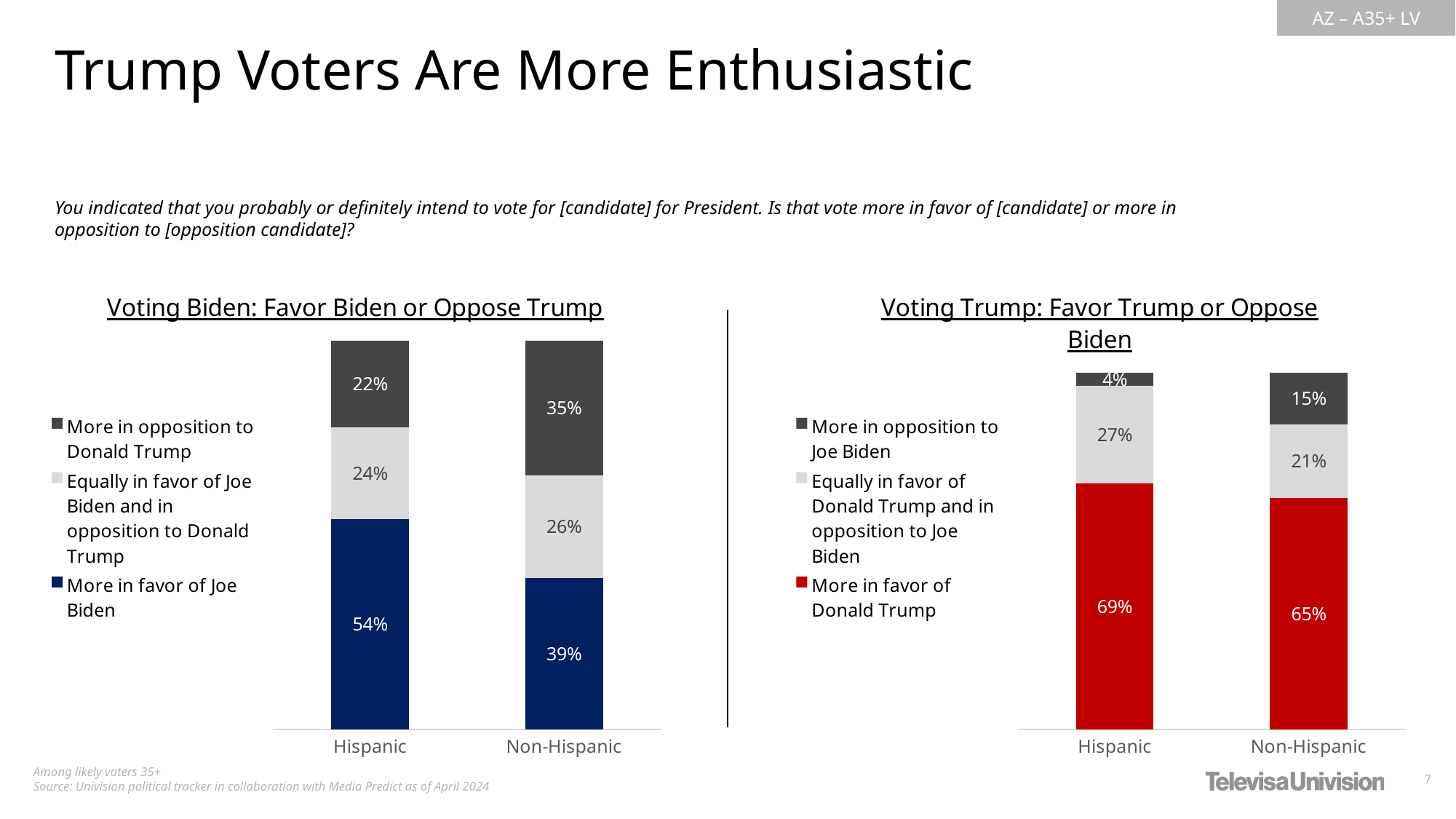
What type of chart is the 'Voting Biden: Favor Biden or Oppose Trump' chart? Stacked bar chart How many series does the legend of the 'Voting Biden: Favor Biden or Oppose Trump' chart list? 3 How many categories are shown on the x axis of the 'Voting Trump: Favor Trump or Oppose Biden' chart? 2 In the 'Voting Trump: Favor Trump or Oppose Biden' chart, which group has the higher value for 'More in favor of Donald Trump', Hispanic or Non-Hispanic? Hispanic In the 'Voting Trump: Favor Trump or Oppose Biden' chart, what is the total of the Hispanic stacked bar? 100% In the 'Voting Biden: Favor Biden or Oppose Trump' chart, what is the difference between the Hispanic and Non-Hispanic values for 'More in favor of Joe Biden'? 15% In the 'Voting Biden: Favor Biden or Oppose Trump' chart, which segment is the smallest for Hispanic voters? More in opposition to Donald Trump In the 'Voting Biden: Favor Biden or Oppose Trump' chart, what percentage of Hispanic voters are 'More in favor of Joe Biden'? 54% In the 'Voting Trump: Favor Trump or Oppose Biden' chart, what percentage of Non-Hispanic voters are 'Equally in favor of Donald Trump and in opposition to Joe Biden'? 21% In the 'Voting Trump: Favor Trump or Oppose Biden' chart, what percentage of Hispanic voters are 'More in favor of Donald Trump'? 69% In the 'Voting Trump: Favor Trump or Oppose Biden' chart, what is the difference between the Non-Hispanic and Hispanic values for 'More in opposition to Joe Biden'? 11% In the 'Voting Biden: Favor Biden or Oppose Trump' chart, what percentage of Non-Hispanic voters are 'More in opposition to Donald Trump'? 35%